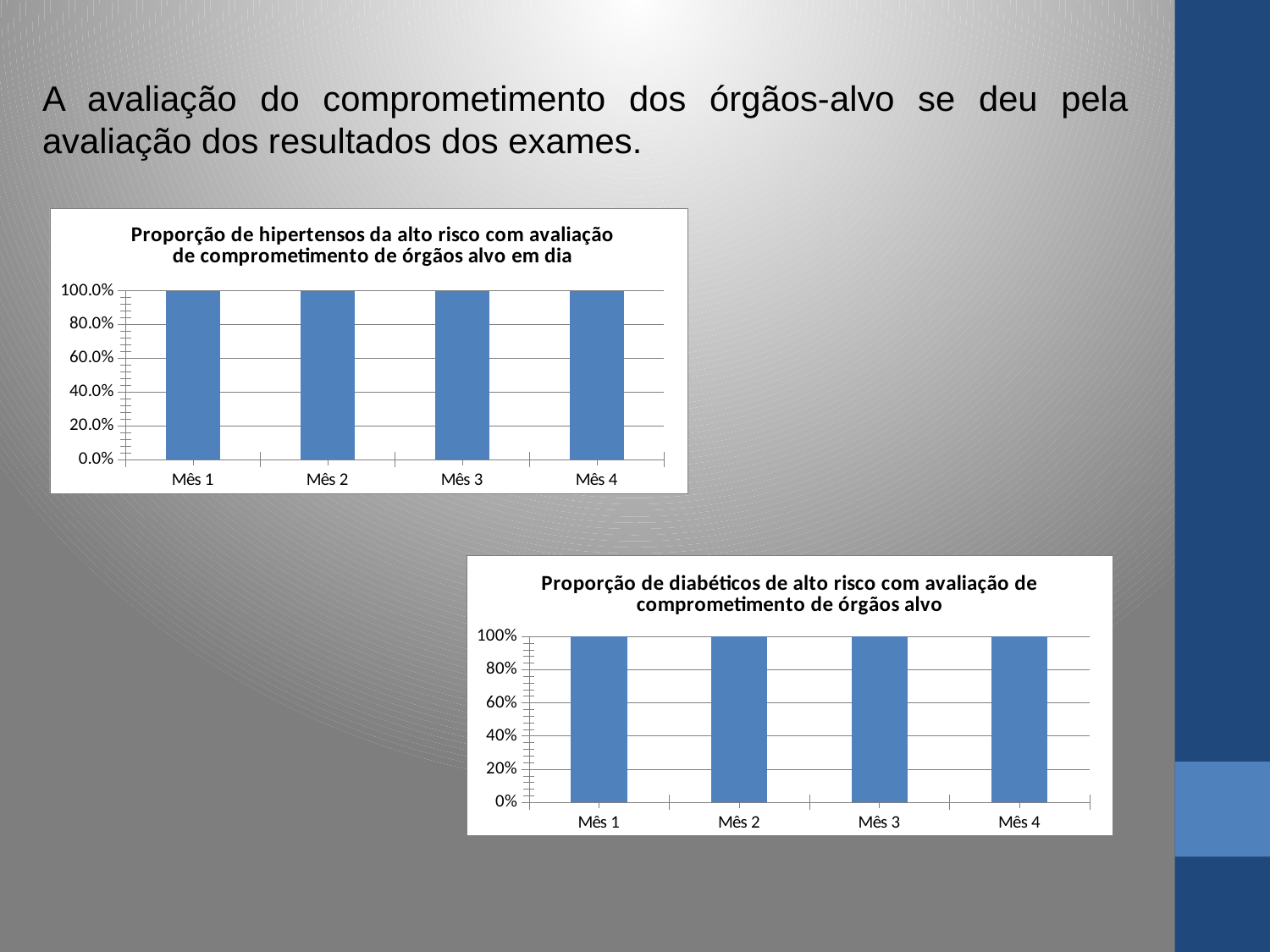
How many categories are shown on the x axis of the top chart (Proporção de hipertensos da alto risco com avaliação de comprometimento de órgãos alvo em dia)? 4 In the bottom chart (Proporção de diabéticos de alto risco com avaliação de comprometimento de órgãos alvo), is the value for Mês 1 greater or less than 80%? greater What kind of chart is the bottom chart (Proporção de diabéticos de alto risco com avaliação de comprometimento de órgãos alvo)? Bar chart In the top chart (Proporção de hipertensos da alto risco com avaliação de comprometimento de órgãos alvo em dia), do the values rise, fall or stay the same from Mês 1 to Mês 4? Stay the same In the top chart (Proporção de hipertensos da alto risco com avaliação de comprometimento de órgãos alvo em dia), what is the value for Mês 4? 100.0% What is the title of the bottom chart on the slide? Proporção de diabéticos de alto risco com avaliação de comprometimento de órgãos alvo In the bottom chart (Proporção de diabéticos de alto risco com avaliação de comprometimento de órgãos alvo), what is the value for Mês 3? 100% What kind of chart is the top chart (Proporção de hipertensos da alto risco com avaliação de comprometimento de órgãos alvo em dia)? Bar chart In the bottom chart (Proporção de diabéticos de alto risco com avaliação de comprometimento de órgãos alvo), what is the value for Mês 2? 100% How many bars are plotted in the bottom chart (Proporção de diabéticos de alto risco com avaliação de comprometimento de órgãos alvo)? 4 In the top chart (Proporção de hipertensos da alto risco com avaliação de comprometimento de órgãos alvo em dia), what is the value for Mês 1? 100.0% In the top chart (Proporção de hipertensos da alto risco com avaliação de comprometimento de órgãos alvo em dia), what is the difference between the values for Mês 2 and Mês 3? 0.0%